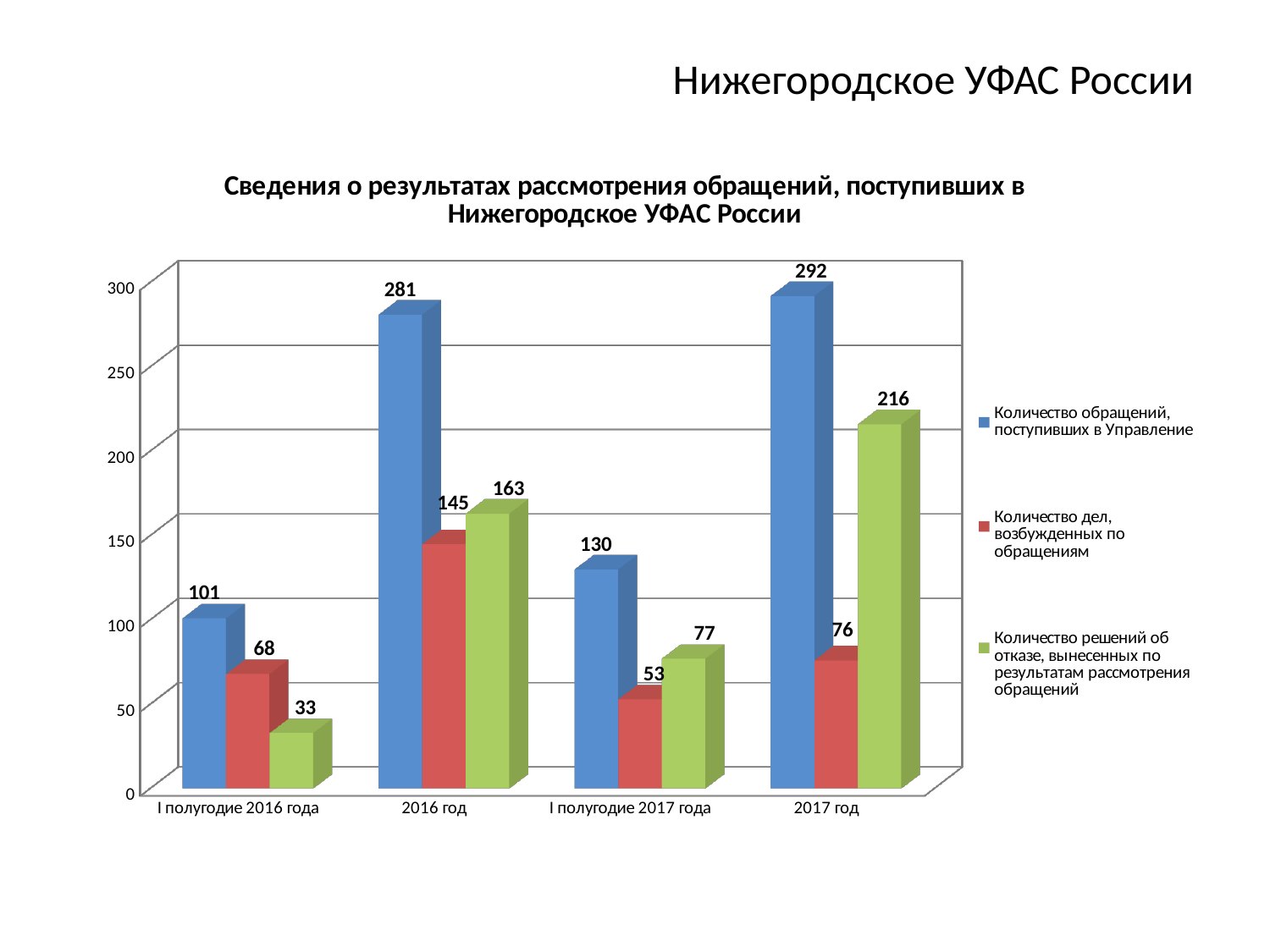
Which category has the lowest value for "Количество решений об отказе, вынесенных по результатам рассмотрения обращений"? I полугодие 2016 года What is the value of "Количество обращений, поступивших в Управление" for "2016 год"? 281 What is the difference between "Количество обращений, поступивших в Управление" for "2017 год" and for "2016 год"? 11 What is the title of the chart? Сведения о результатах рассмотрения обращений, поступивших в Нижегородское УФАС России What kind of chart is shown on the slide? Bar chart How many categories are shown on the x axis? 4 Is the value of "Количество обращений, поступивших в Управление" for "I полугодие 2017 года" greater or less than 100? greater Which is larger: "Количество дел, возбужденных по обращениям" for "2016 год" or "Количество решений об отказе, вынесенных по результатам рассмотрения обращений" for "2016 год"? Количество решений об отказе, вынесенных по результатам рассмотрения обращений How many series does the legend list? 3 Which category has the highest value for "Количество обращений, поступивших в Управление"? 2017 год What is the value of "Количество решений об отказе, вынесенных по результатам рассмотрения обращений" for "2017 год"? 216 What is the value of "Количество дел, возбужденных по обращениям" for "I полугодие 2017 года"? 53